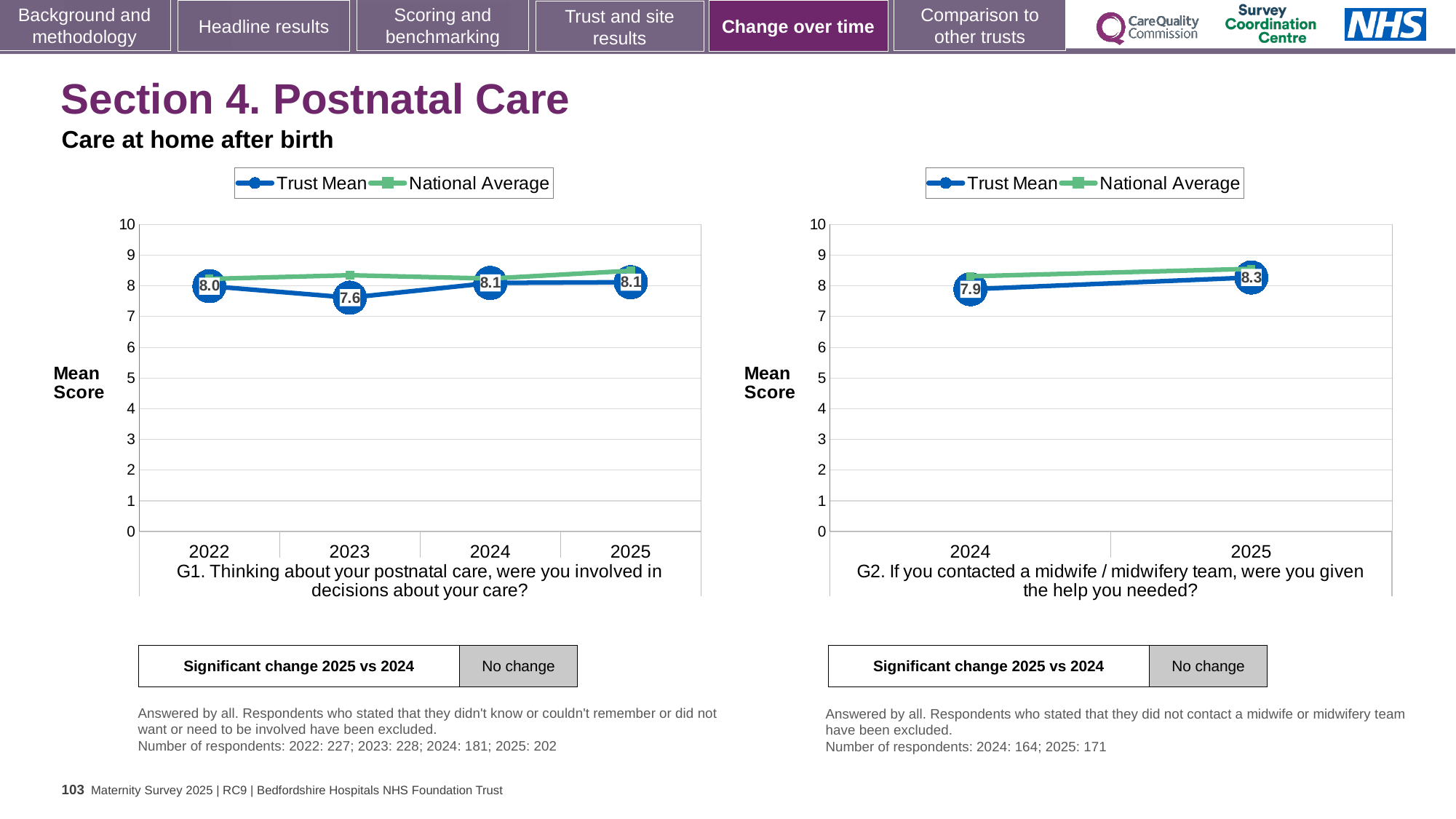
In the G1 chart on the left, what is the difference between the Trust Mean scores for 2024 and 2023? 0.5 In the G1 chart on the left, which year has the lowest Trust Mean score? 2023 In the G1 chart on the left, what is the Trust Mean score for 2023? 7.6 How many years are shown on the x axis of the G1 chart on the left? 4 In the G2 chart on the right, what is the Trust Mean score for 2024? 7.9 In the G2 chart on the right, is the National Average value for 2025 greater or less than 7? greater In the G1 chart on the left, what is the Trust Mean score for 2022? 8.0 In the G2 chart on the right, does the Trust Mean rise or fall from 2024 to 2025? rise In the G1 chart on the left, is the Trust Mean score for 2022 or 2023 larger? 2022 In the G2 chart on the right, what is the difference between the Trust Mean scores for 2025 and 2024? 0.4 In the G2 chart on the right, what is the Trust Mean score for 2025? 8.3 How many series does the legend of the G2 chart on the right list? 2